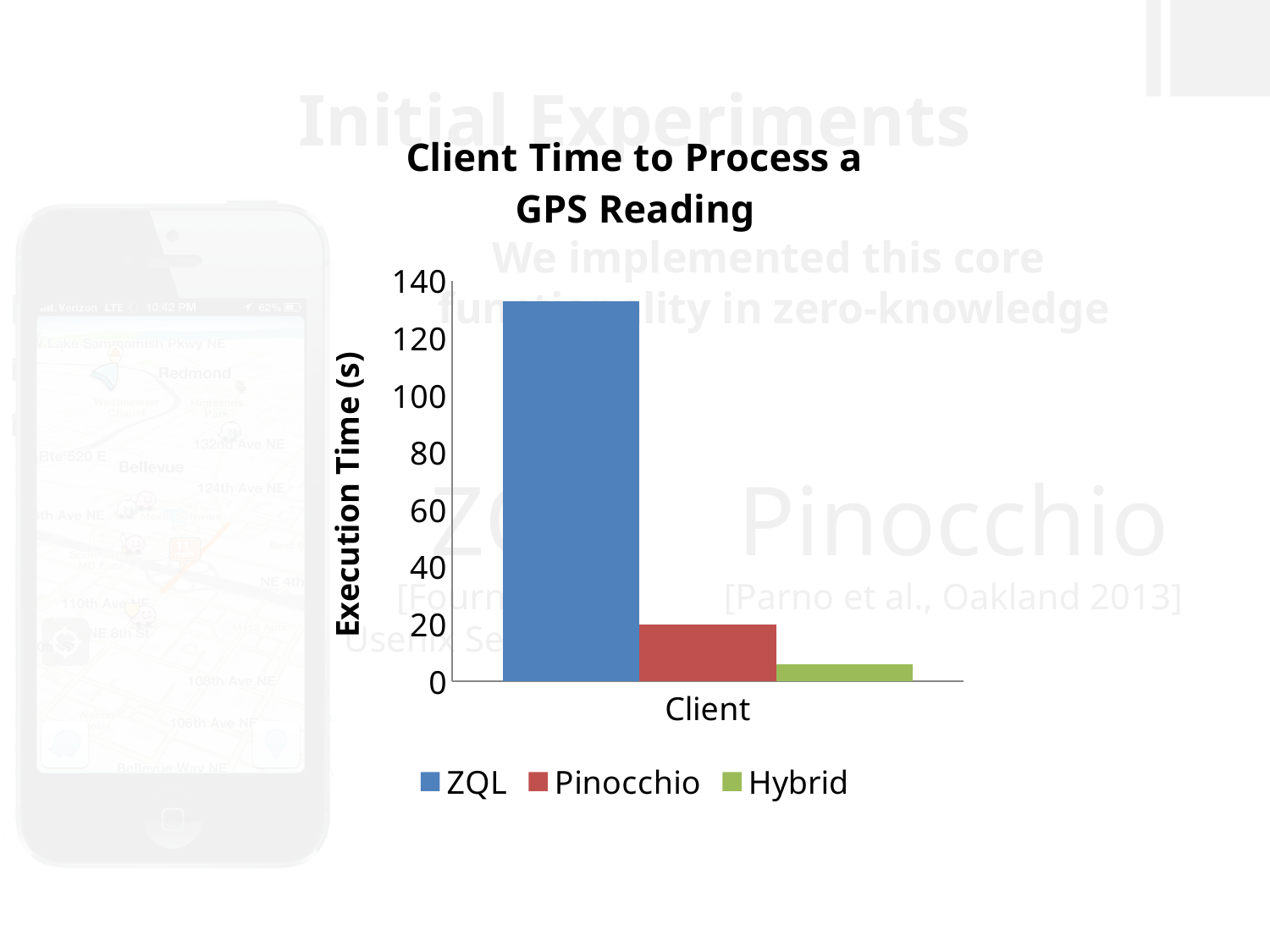
How many series does the chart's legend list? 3 What is the title of the chart? Client Time to Process a GPS Reading Is the execution time for ZQL greater or less than 120? greater Which series has the lowest execution time? Hybrid What kind of chart is shown on the slide? bar chart How many categories are shown on the x axis? 1 Is the execution time for Pinocchio greater or less than 40? less Which series has the highest execution time? ZQL Which has a larger execution time, Pinocchio or Hybrid? Pinocchio Is the execution time for Hybrid greater or less than 20? less What is the label of the y axis? Execution Time (s) Which has a larger execution time, ZQL or Pinocchio? ZQL